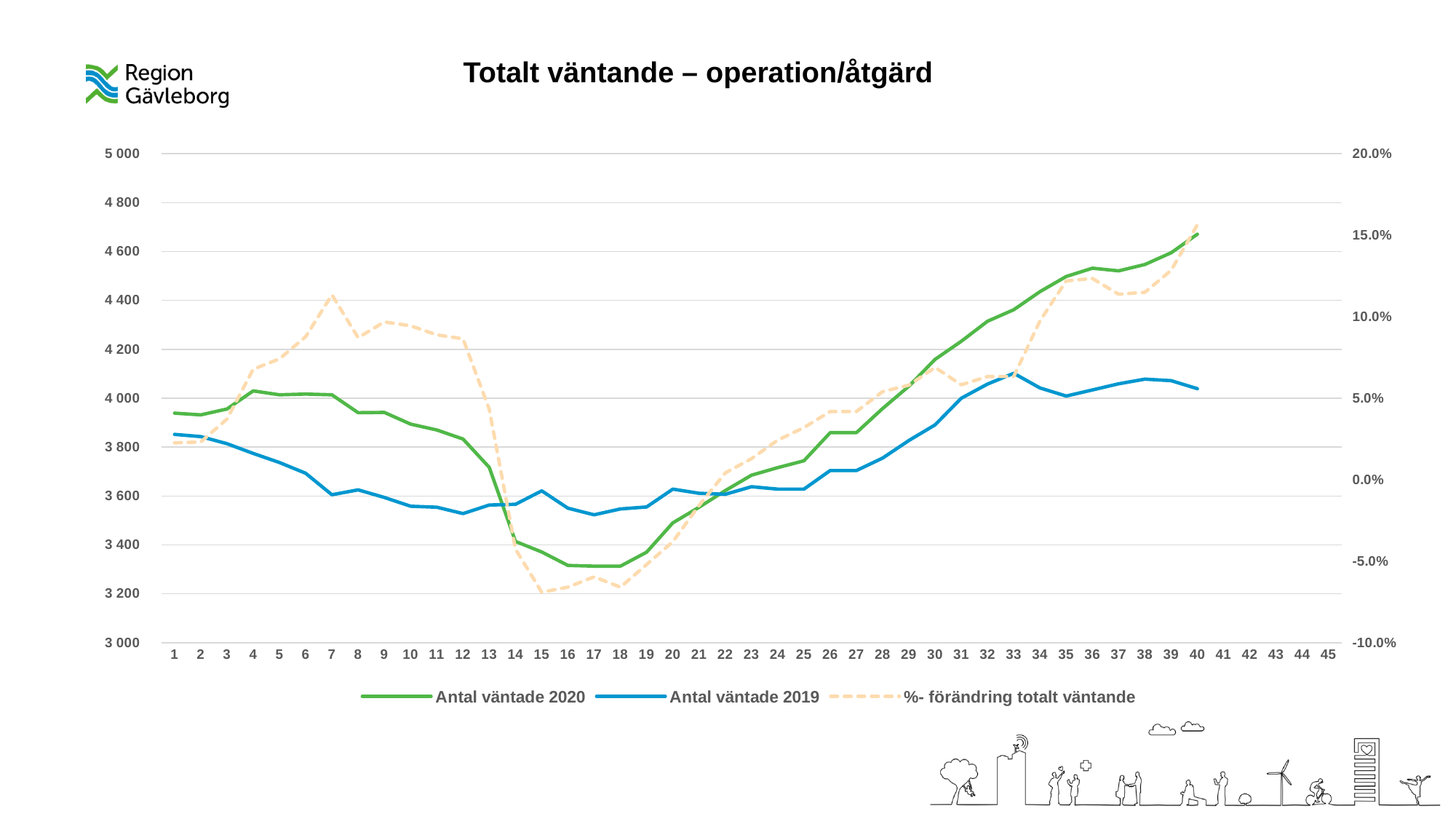
Is the value for Antal väntade 2020 at week 16 greater or less than 3 400? less What is the title of the chart? Totalt väntande – operation/åtgärd How many series does the legend list? 3 At week 16, which is larger: Antal väntade 2020 or Antal väntade 2019? Antal väntade 2019 Is the value for Antal väntade 2020 at week 40 greater or less than 4 600? greater Is the value for Antal väntade 2019 at week 40 greater or less than 4 000? greater At week 10, which is larger: Antal väntade 2020 or Antal väntade 2019? Antal väntade 2020 How many week labels are shown on the x axis? 45 What kind of chart is shown on the slide? line chart Which series is drawn as a dashed line? %- förändring totalt väntande At which week does Antal väntade 2020 reach its highest value? 40